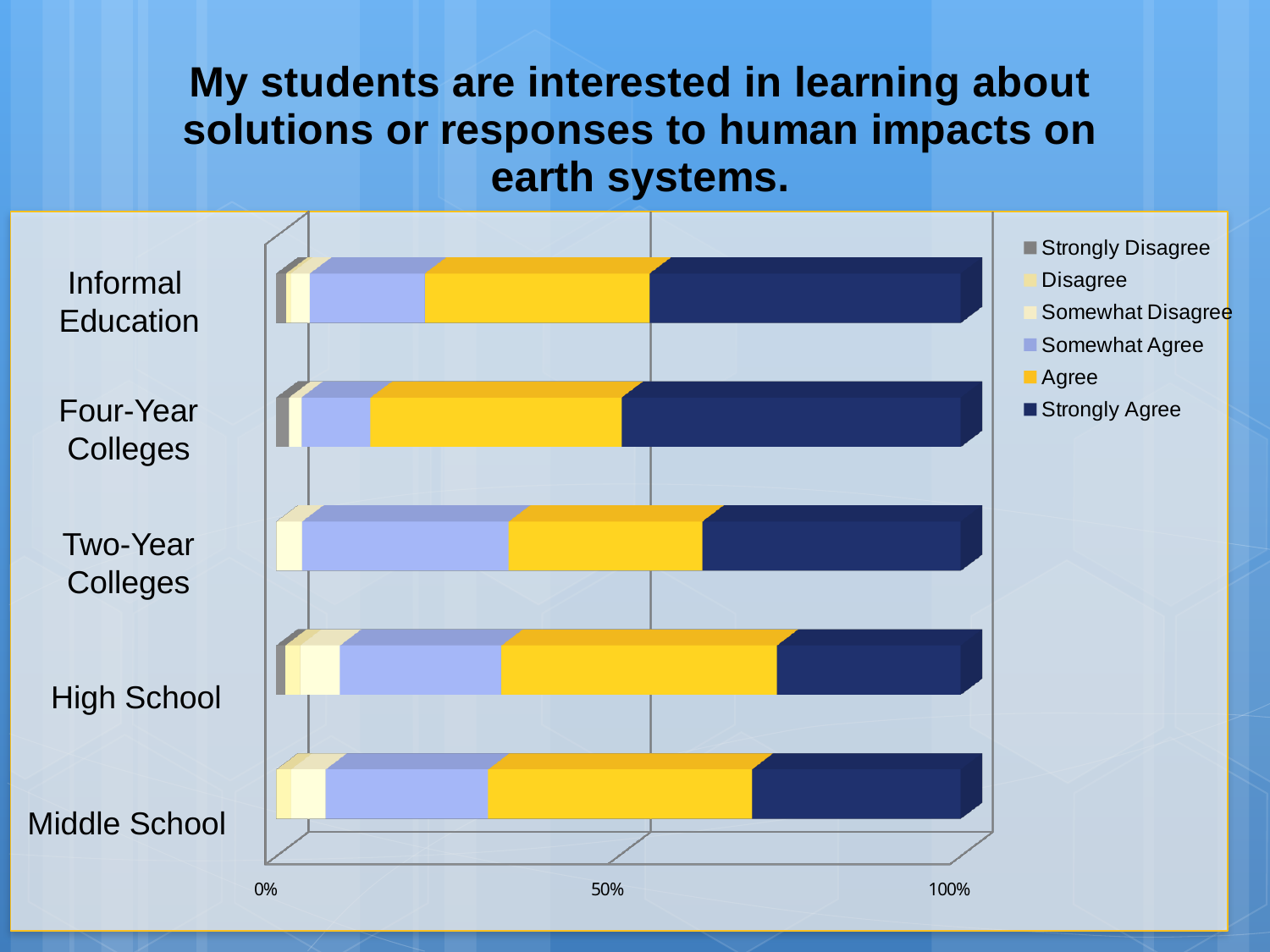
Which category has the largest Somewhat Agree segment? Two-Year Colleges What is the highest value labelled on the horizontal axis? 100% Is the Strongly Agree share for Middle School greater or less than 50%? less What kind of chart is shown on the slide? Stacked bar chart Is the Strongly Agree share for Informal Education greater or less than 50%? less How many categories (education levels) are plotted on the chart? 5 What is the title of the chart? My students are interested in learning about solutions or responses to human impacts on earth systems. Which has the larger Strongly Agree segment, Two-Year Colleges or Middle School? Two-Year Colleges How many series does the legend list? 6 Which has the larger Somewhat Agree segment, Two-Year Colleges or Four-Year Colleges? Two-Year Colleges Which category has the smallest Somewhat Agree segment? Four-Year Colleges